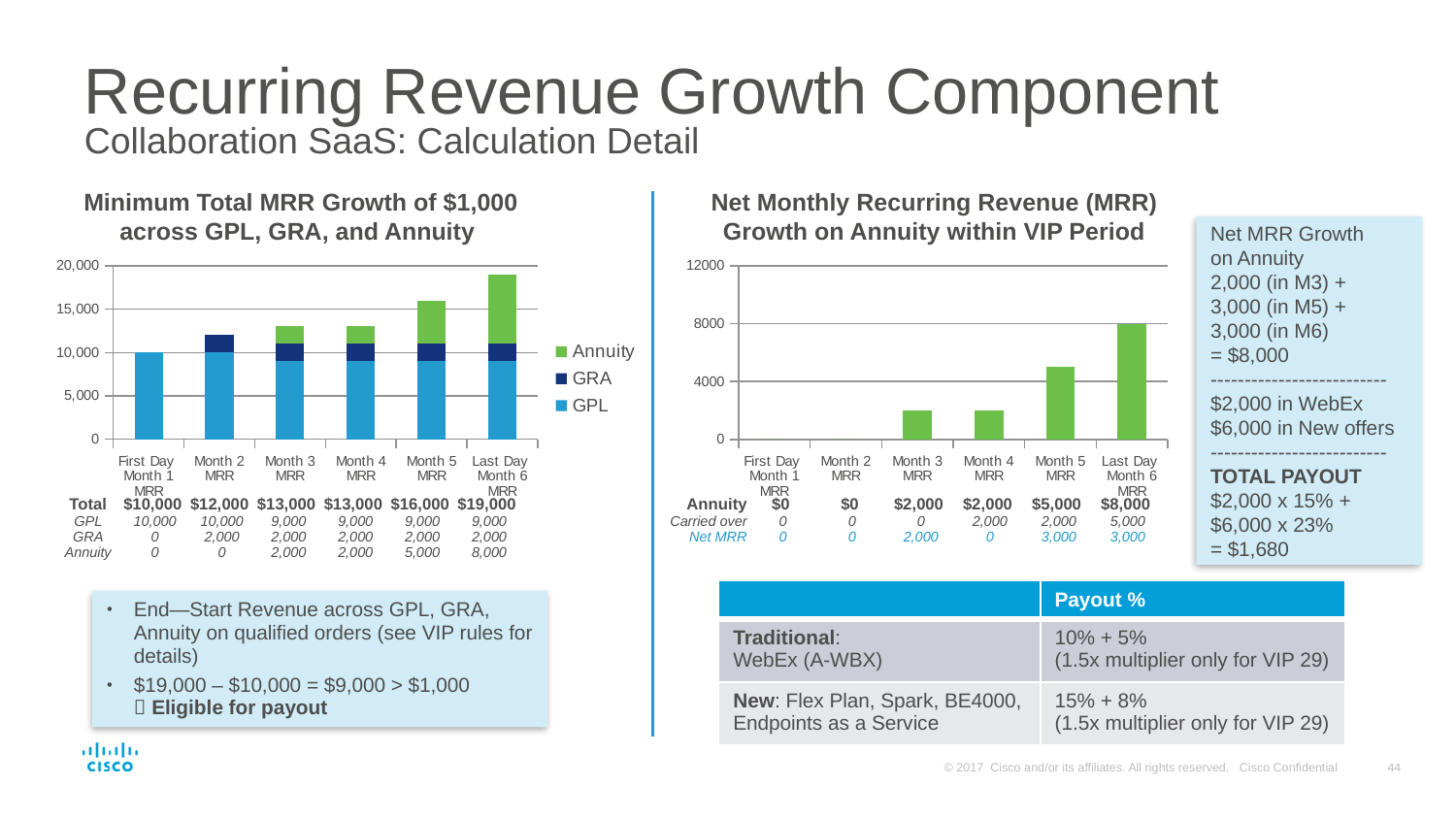
In the right chart, 'Net Monthly Recurring Revenue (MRR) Growth on Annuity within VIP Period', what is the Annuity value for Month 5 MRR? $5,000 In the left chart, 'Minimum Total MRR Growth of $1,000 across GPL, GRA, and Annuity', what is the GPL value for Month 3 MRR? 9,000 In the left chart, 'Minimum Total MRR Growth of $1,000 across GPL, GRA, and Annuity', what type of chart is shown? Stacked bar chart In the left chart, 'Minimum Total MRR Growth of $1,000 across GPL, GRA, and Annuity', what is the difference between the total for Last Day Month 6 MRR and the total for First Day Month 1 MRR? $9,000 In the left chart, 'Minimum Total MRR Growth of $1,000 across GPL, GRA, and Annuity', do the totals generally rise or fall from First Day Month 1 to Last Day Month 6? Rise In the left chart, 'Minimum Total MRR Growth of $1,000 across GPL, GRA, and Annuity', what is the Annuity value for Month 5 MRR? 5,000 In the left chart, 'Minimum Total MRR Growth of $1,000 across GPL, GRA, and Annuity', how many series does the legend list? 3 In the right chart, 'Net Monthly Recurring Revenue (MRR) Growth on Annuity within VIP Period', is the value for Last Day Month 6 MRR greater or less than 4000? greater In the right chart, 'Net Monthly Recurring Revenue (MRR) Growth on Annuity within VIP Period', which is larger, the Annuity value for Month 4 MRR or for Month 5 MRR? Month 5 MRR In the left chart, 'Minimum Total MRR Growth of $1,000 across GPL, GRA, and Annuity', what is the total for Last Day Month 6 MRR? $19,000 In the left chart, 'Minimum Total MRR Growth of $1,000 across GPL, GRA, and Annuity', which category has the highest total? Last Day Month 6 MRR In the right chart, 'Net Monthly Recurring Revenue (MRR) Growth on Annuity within VIP Period', how many categories are shown on the x axis? 6